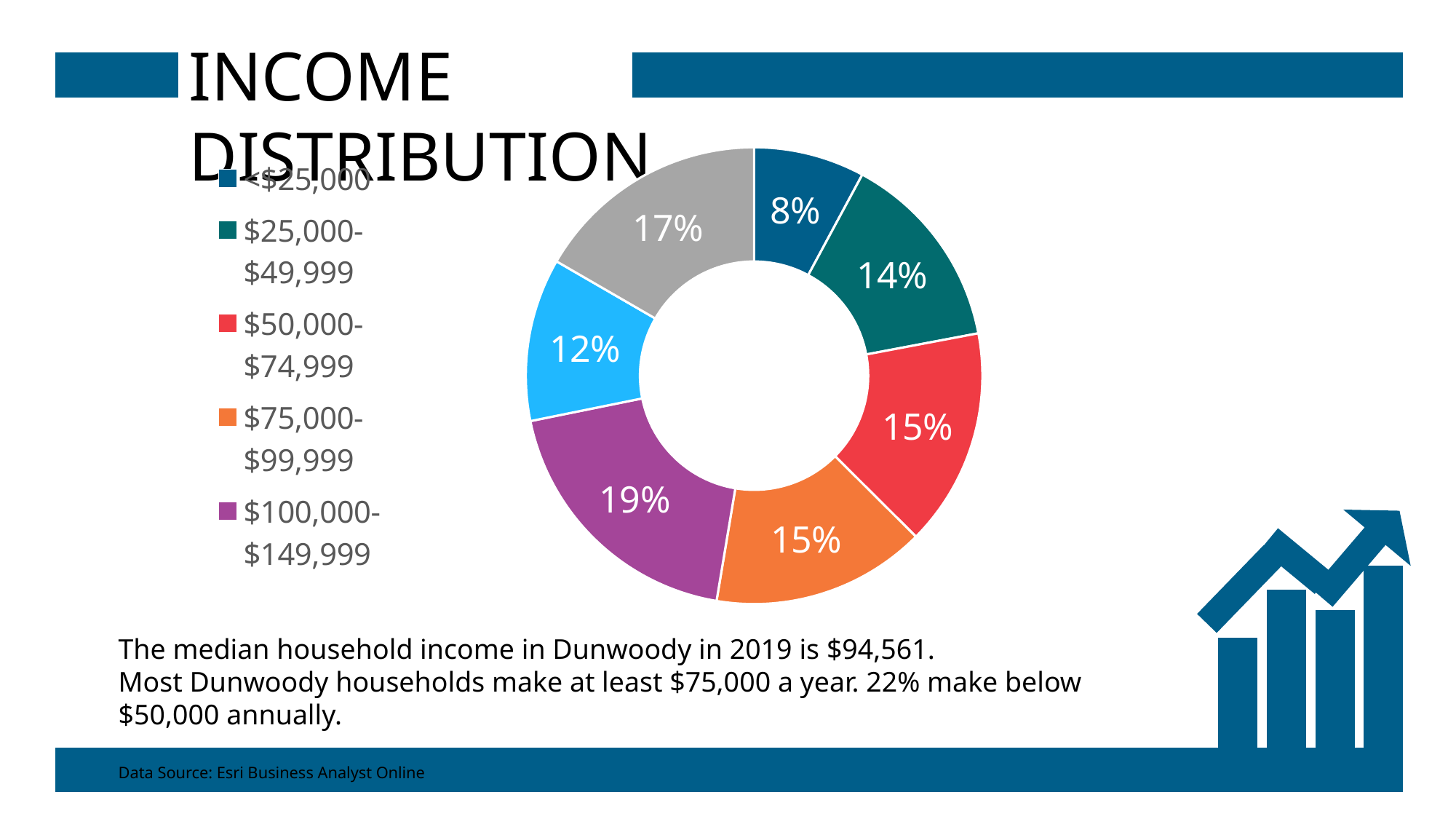
What colour represents the $75,000-$99,999 category in the chart? Orange Which income category has the smallest share of the chart? <$25,000 Which income category has the largest share of the chart? $100,000-$149,999 What percentage is shown on the gray slice of the chart? 17% What percentage is shown for the $50,000-$74,999 category? 15% How many slices does the chart have? 7 What percentage of households fall in the <$25,000 income category? 8% What share of households is shown for the $25,000-$49,999 category? 14% What kind of chart is shown on the slide? Doughnut (pie) chart Which is larger: the share for $25,000-$49,999 or the share for $50,000-$74,999? $50,000-$74,999 What percentage is shown for the $100,000-$149,999 category? 19% How many percentage points larger is the $100,000-$149,999 share than the <$25,000 share? 11